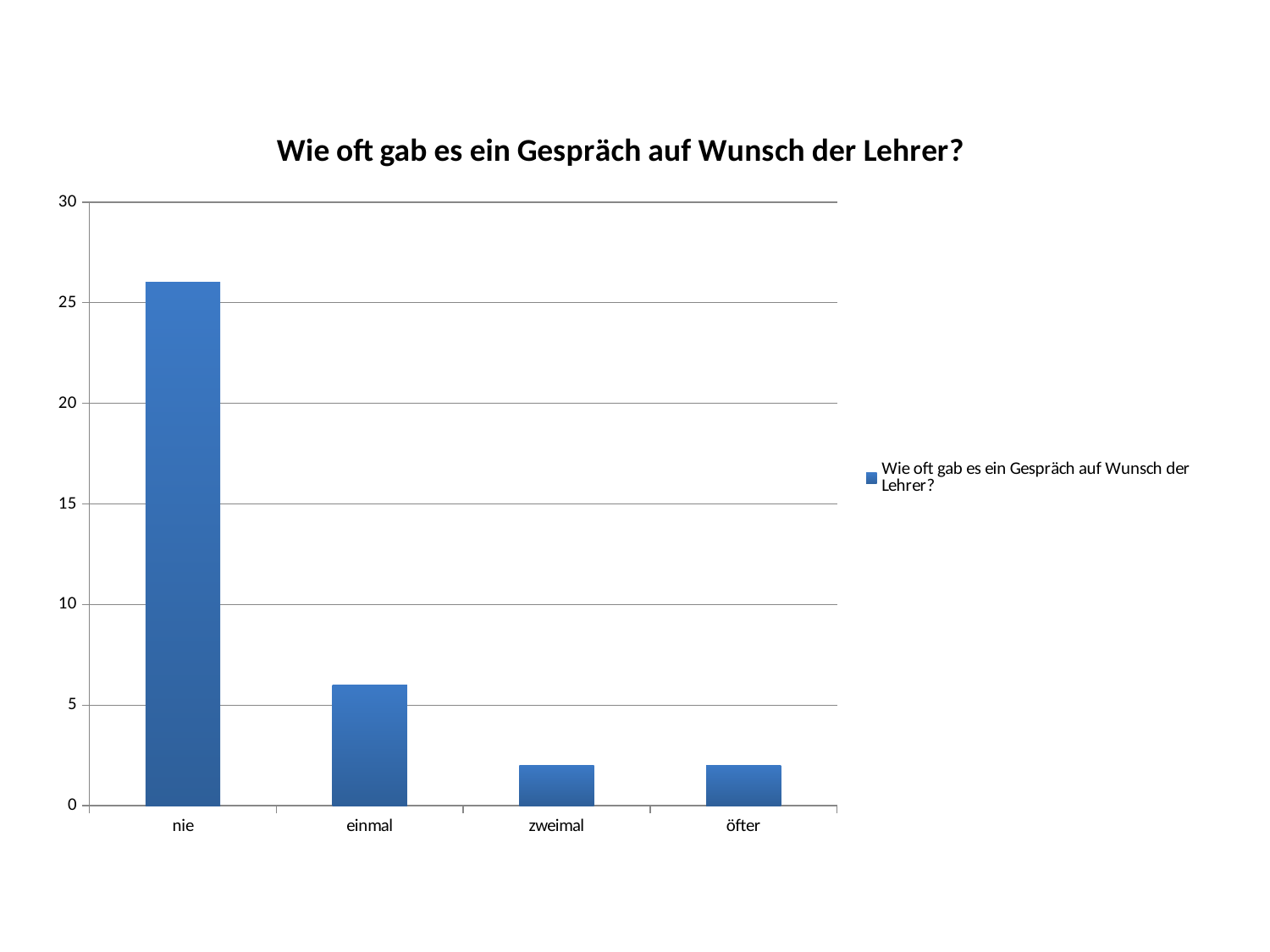
What kind of chart is shown on the slide? bar chart Is the value for öfter greater or less than 5? less How many categories are shown on the x axis? 4 Which category has the highest value? nie Is the value for nie greater or less than 25? greater Do the values rise or fall from nie to öfter along the x axis? fall What is the title of the chart? Wie oft gab es ein Gespräch auf Wunsch der Lehrer? How many series does the legend list? 1 Is the value for zweimal greater or less than 5? less Which is larger, the value for einmal or the value for zweimal? einmal Which is larger, the value for nie or the value for einmal? nie